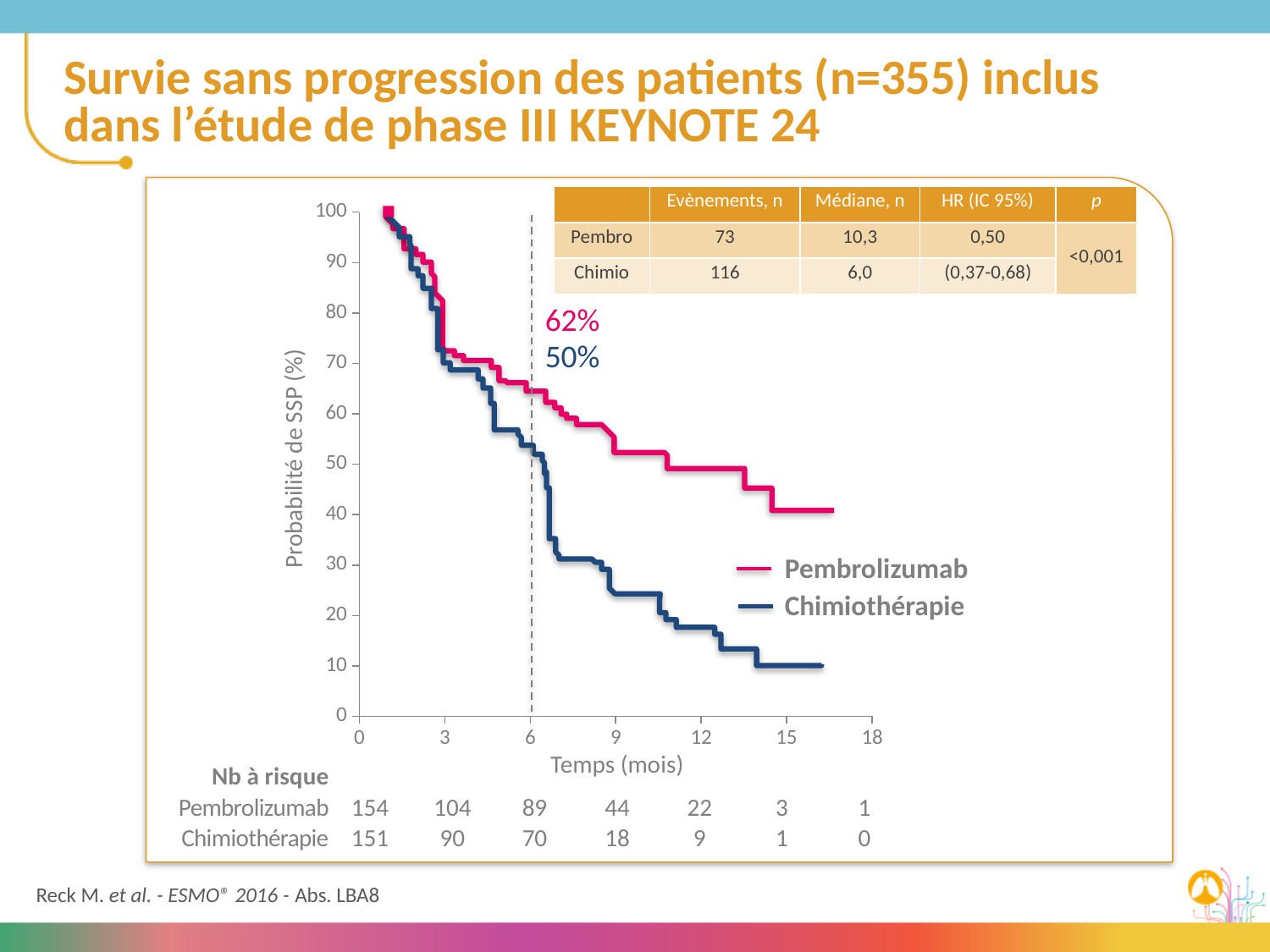
At 6 months, which curve is higher: Pembrolizumab or Chimiothérapie? Pembrolizumab Do the survival curves rise or fall as time (mois) increases? Fall What kind of chart is shown on the slide? Line chart What is the difference between the annotated 6-month values for Pembrolizumab and Chimiothérapie? 12 percentage points How many series does the legend list? 2 What is the progression-free survival probability for Chimiothérapie at 6 months, as annotated on the chart? 50% According to the table on the chart, what is the median (Médiane, n) for Pembro? 10,3 What is the label of the y axis? Probabilité de SSP (%) What is the progression-free survival probability for Pembrolizumab at 6 months, as annotated on the chart? 62% Is the Pembrolizumab curve at 12 months greater or less than 40? greater According to the table on the chart, how many events (Evènements, n) were there in the Chimio group? 116 Is the Chimiothérapie curve at 12 months greater or less than 20? less